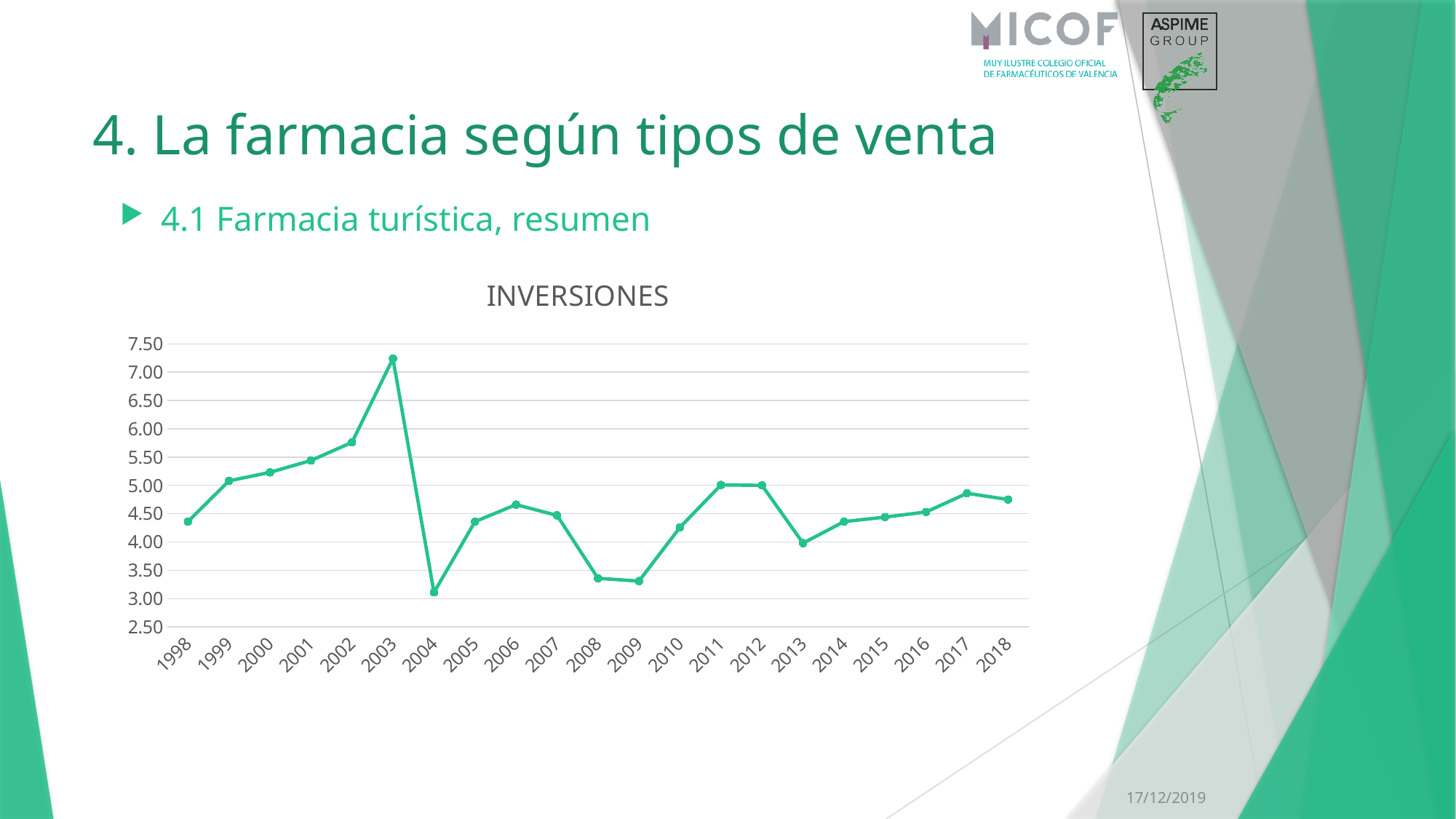
What colour is the line in the chart? green Is the value for 2004 greater or less than 3.50? less Is the value for 2008 greater or less than 3.50? less Which year has the larger value, 2002 or 2010? 2002 What is the title of the chart? INVERSIONES How many years are plotted on the x axis of the chart? 21 Which year has the highest value in the INVERSIONES chart? 2003 Is the value for 2003 greater or less than 7.00? greater Do the values rise or fall from 1998 to 2003? rise What kind of chart is shown on the slide? line chart Which year has the lowest value in the INVERSIONES chart? 2004